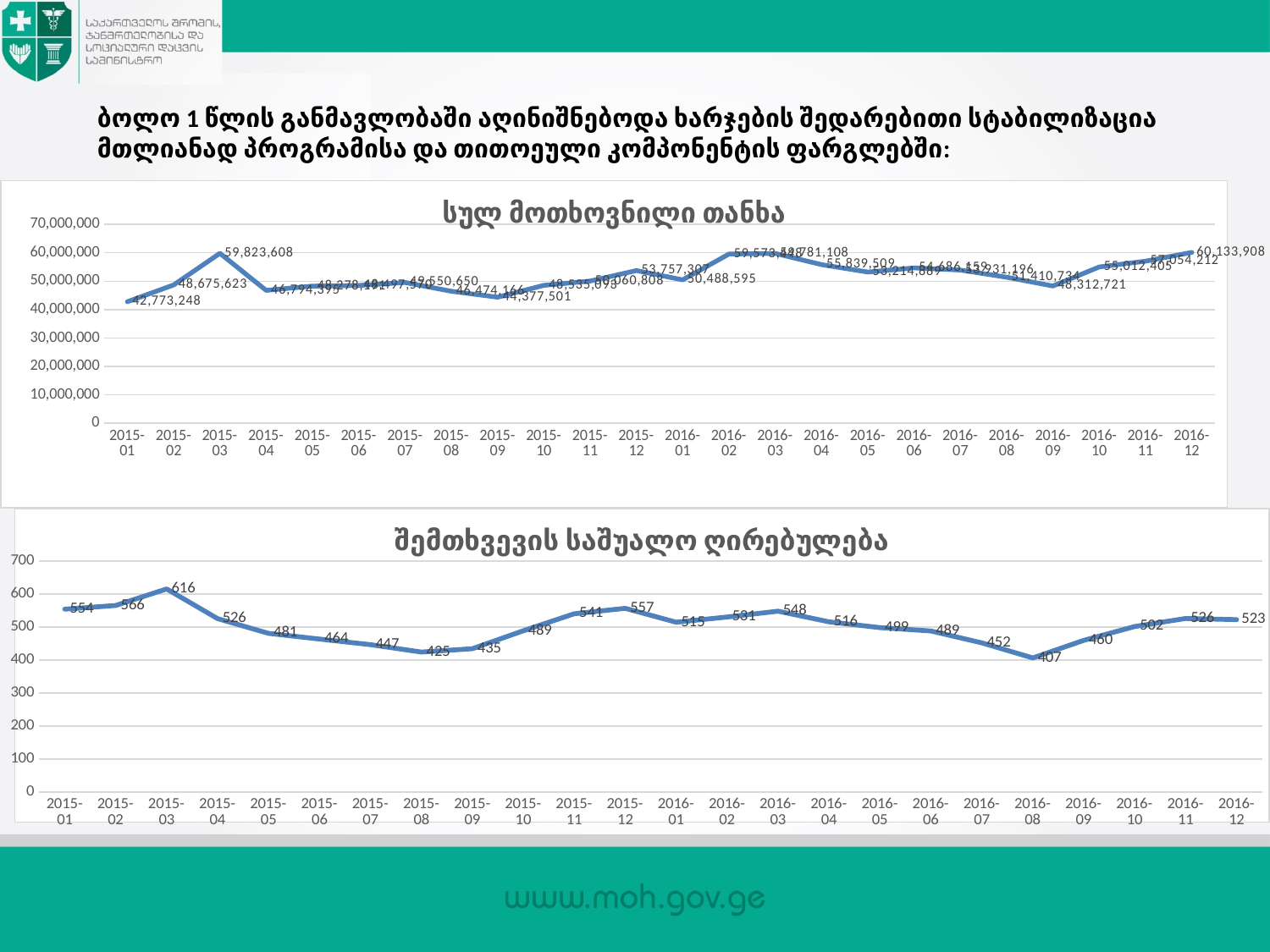
In the bottom chart (შემთხვევის საშუალო ღირებულება), which is larger, the value for 2015-12 or the value for 2016-01? 2015-12 In the top chart (სულ მოთხოვნილი თანხა), what is the value for 2015-01? 42,773,248 In the top chart (სულ მოთხოვნილი თანხა), what is the value for 2016-12? 60,133,908 In the bottom chart (შემთხვევის საშუალო ღირებულება), which month has the lowest value? 2016-08 How many data points are plotted in the bottom chart (შემთხვევის საშუალო ღირებულება)? 24 In the bottom chart (შემთხვევის საშუალო ღირებულება), what is the value for 2015-03? 616 What type of chart is the top chart (სულ მოთხოვნილი თანხა)? line chart In the bottom chart (შემთხვევის საშუალო ღირებულება), do the values rise or fall from 2015-03 to 2015-08? fall In the bottom chart (შემთხვევის საშუალო ღირებულება), what is the difference between the values for 2015-03 and 2016-08? 209 In the bottom chart (შემთხვევის საშუალო ღირებულება), what is the value for 2016-12? 523 In the top chart (სულ მოთხოვნილი თანხა), is the value for 2015-09 greater or less than 50,000,000? less In the top chart (სულ მოთხოვნილი თანხა), which month has the lowest value? 2015-01